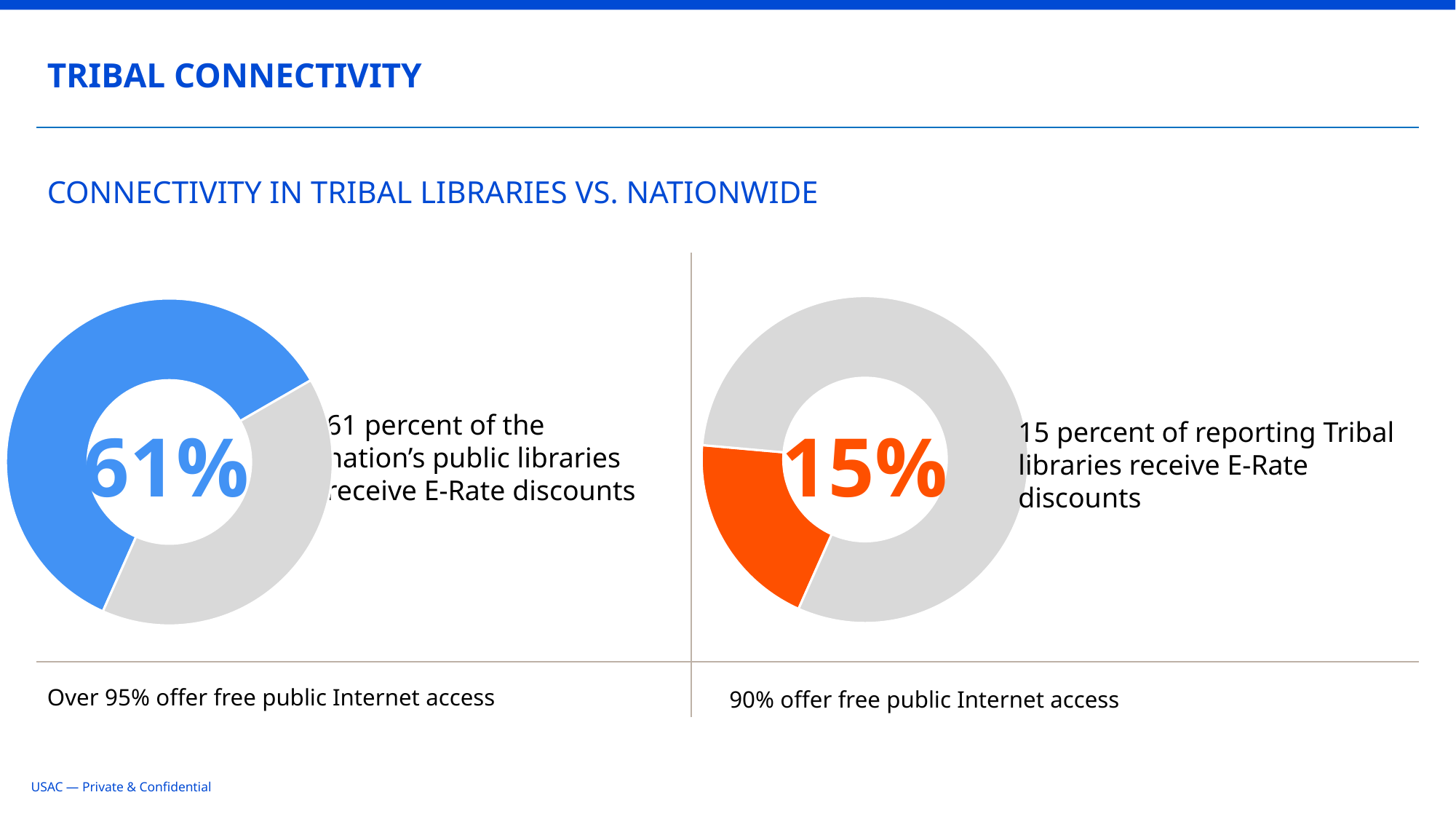
Is the highlighted value in the right chart greater or less than 25%? less What colour is the highlighted segment in the left chart? Blue What is the difference between the percentage shown in the left chart and the percentage shown in the right chart? 46 percentage points Is the highlighted value in the left chart greater or less than 50%? greater In the left chart, what percentage of the nation's public libraries receive E-Rate discounts? 61% Which chart shows the larger highlighted share: the left chart (nation's public libraries) or the right chart (Tribal libraries)? The left chart In the right chart, does the highlighted segment cover more or less than half of the donut? less How many donut charts are on the slide? 2 What type of chart is shown on the right side of the slide? Donut chart What colour is the highlighted segment in the right chart? Orange What type of chart is shown on the left side of the slide? Donut chart In the right chart, what percentage of reporting Tribal libraries receive E-Rate discounts? 15%